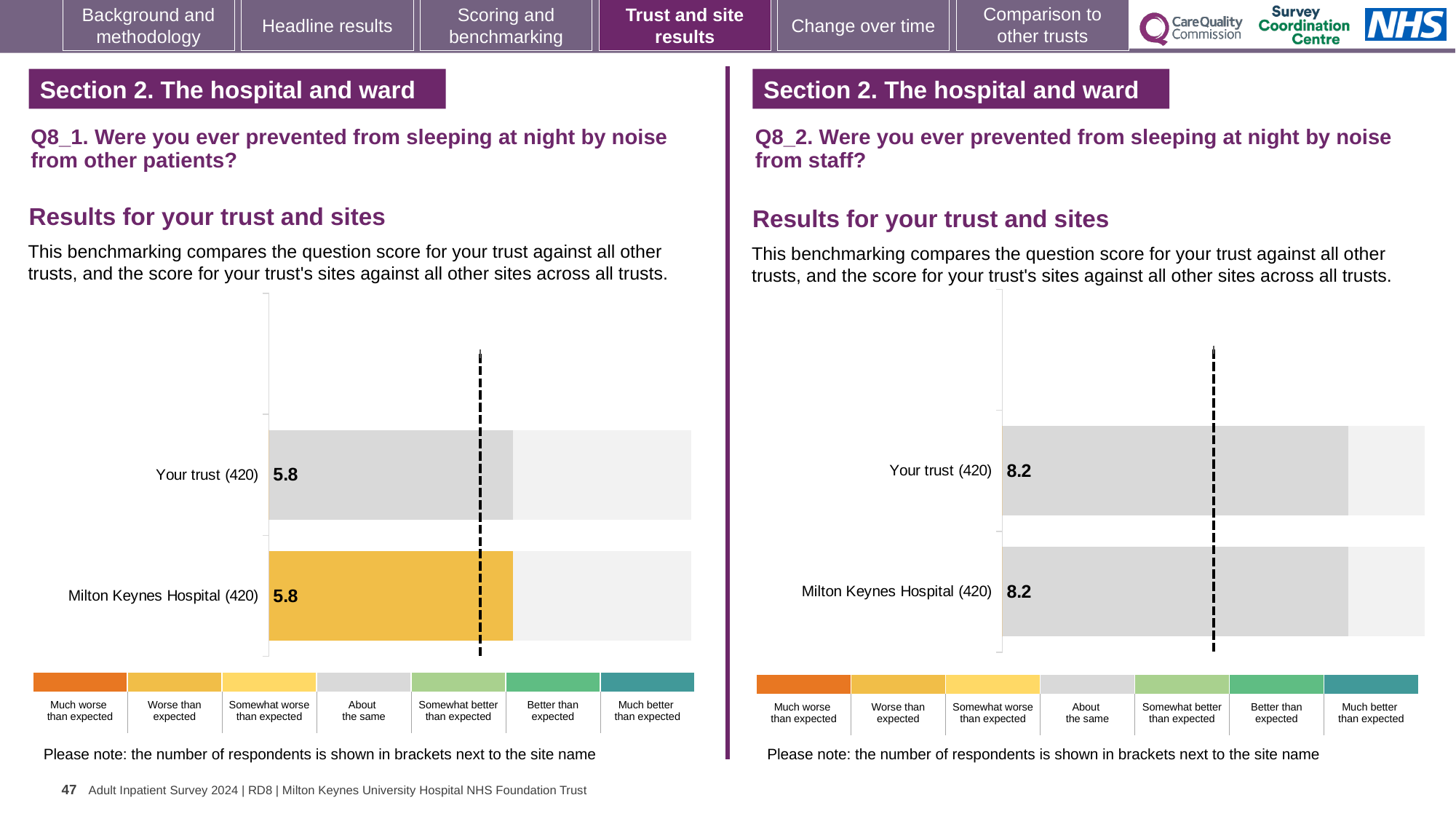
How many bars are plotted in the Q8_2 chart (right)? 2 In the Q8_1 chart (left), what is the score for Your trust? 5.8 In the Q8_2 chart (right), what is the score for Your trust? 8.2 What kind of chart is used for the Q8_1 results (left)? Bar chart In the Q8_1 chart (left), what is the score for Milton Keynes Hospital? 5.8 In the Q8_2 chart (right), what is the difference between the Your trust score and the Milton Keynes Hospital score? 0 In the Q8_1 chart (left), what is the difference between the Your trust score and the Milton Keynes Hospital score? 0 Is the Milton Keynes Hospital score in the Q8_2 chart (right) larger or smaller than the Milton Keynes Hospital score in the Q8_1 chart (left)? Larger In the Q8_1 chart (left), which benchmark category does the colour of the Milton Keynes Hospital bar correspond to in the legend? Worse than expected In the Q8_1 chart (left), how many respondents are shown in brackets for Milton Keynes Hospital? 420 In the Q8_2 chart (right), what is the score for Milton Keynes Hospital? 8.2 How many bars are plotted in the Q8_1 chart (left)? 2